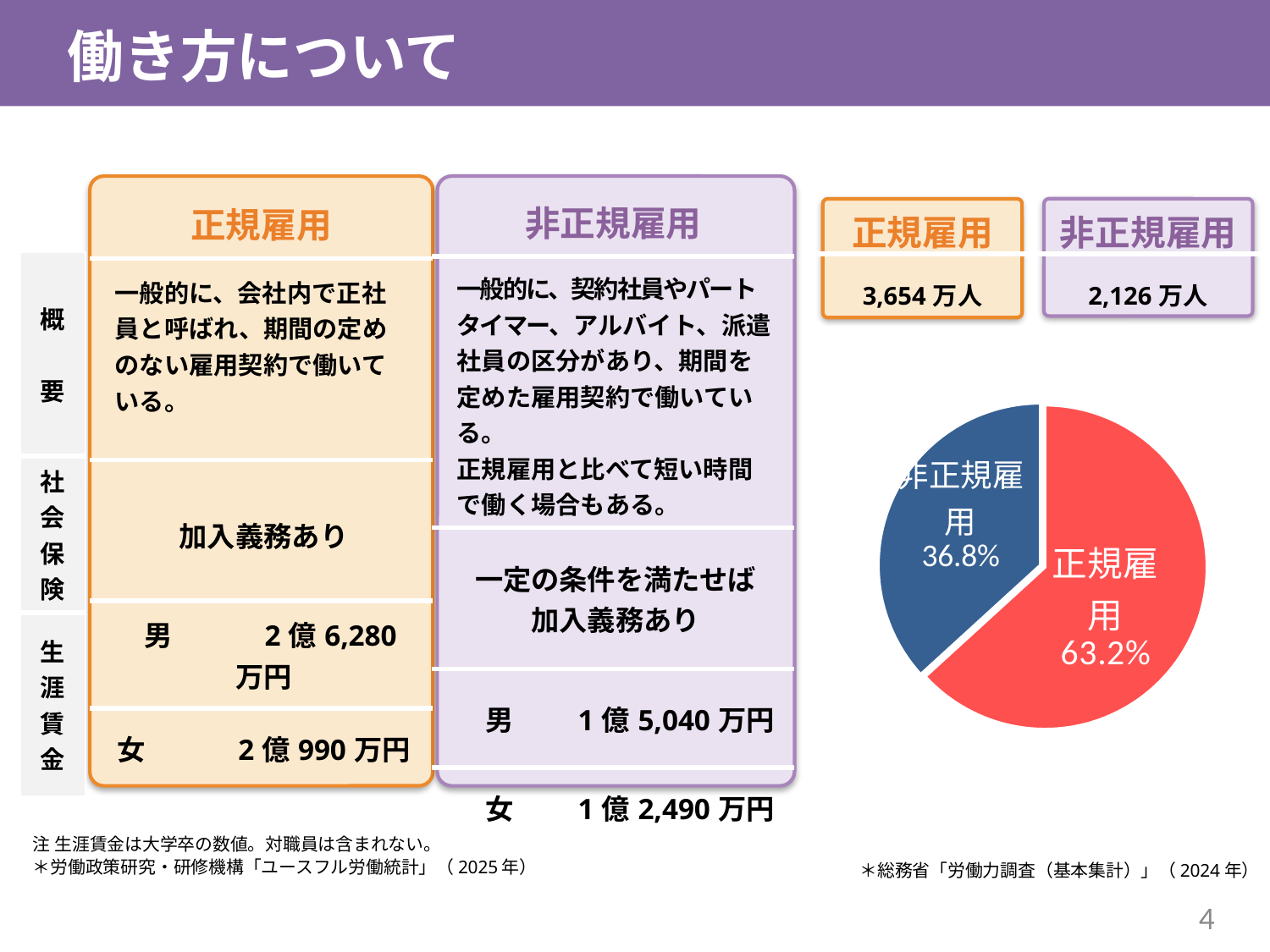
How many slices does the pie chart have? 2 What share of the pie chart does 正規雇用 represent? 63.2% Which slice of the pie chart is the smallest? 非正規雇用 In the pie chart, which is larger: 正規雇用 or 非正規雇用? 正規雇用 What colour is the 非正規雇用 slice in the pie chart? blue What share of the pie chart does 非正規雇用 represent? 36.8% What colour is the 正規雇用 slice in the pie chart? red What is the difference in percentage points between the 正規雇用 slice and the 非正規雇用 slice in the pie chart? 26.4 Is the share of 非正規雇用 in the pie chart greater or less than 50%? less Which slice of the pie chart is the largest? 正規雇用 What kind of chart is shown on the slide? pie chart Is the share of 正規雇用 in the pie chart greater or less than 60%? greater